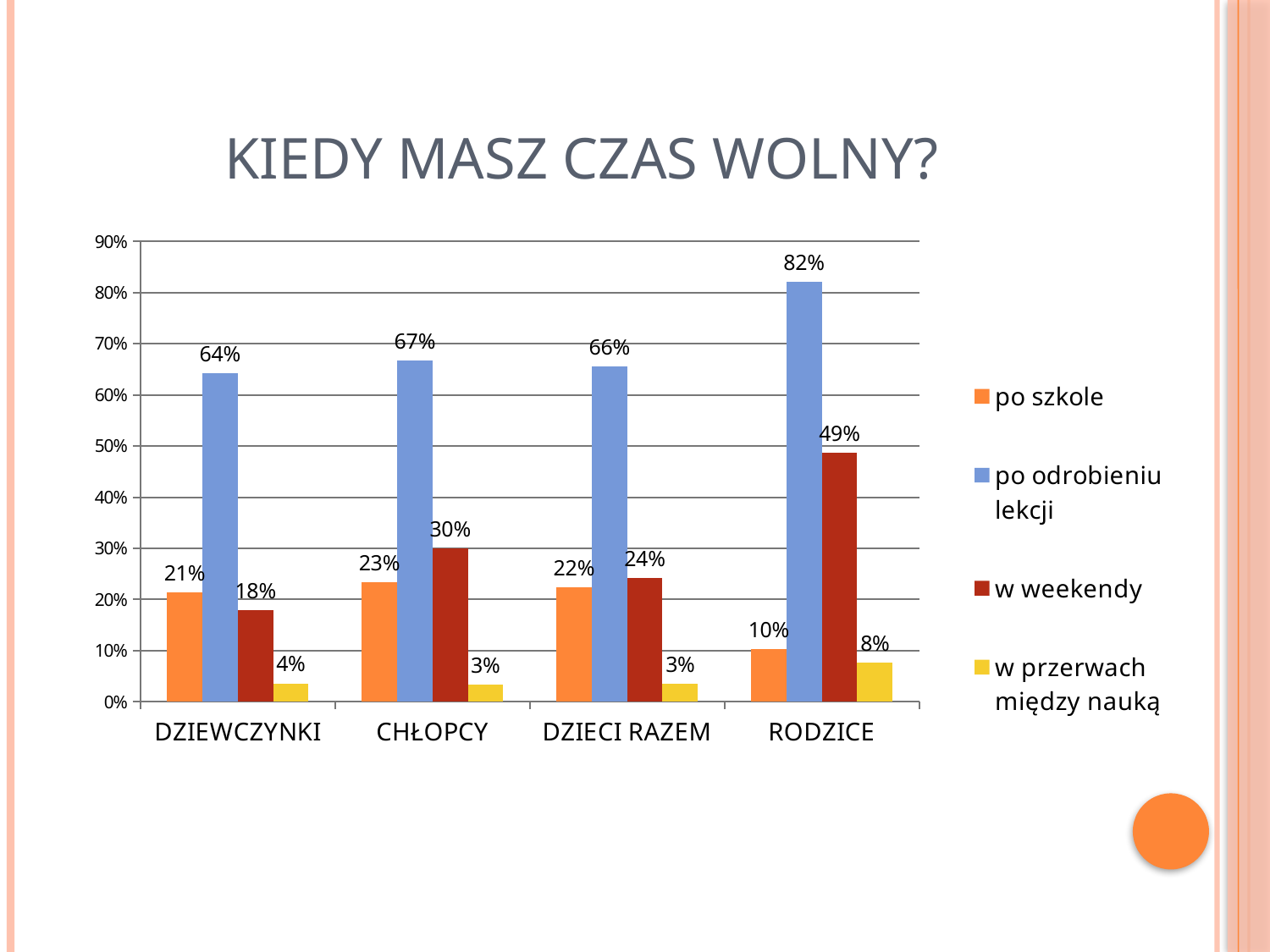
What is the title of the chart on the slide? KIEDY MASZ CZAS WOLNY? Which category has the highest value for 'po odrobieniu lekcji'? RODZICE What kind of chart is shown on the slide? Bar chart What is the difference between the 'w weekendy' values for RODZICE and DZIEWCZYNKI? 31% What is the value for 'po odrobieniu lekcji' in the RODZICE category? 82% How many categories are shown on the x axis? 4 Which is larger: 'po szkole' for CHŁOPCY or 'po szkole' for RODZICE? CHŁOPCY What is the value for 'w weekendy' in the CHŁOPCY category? 30% Which category has the lowest value for 'po szkole'? RODZICE What is the value for 'w przerwach między nauką' in the RODZICE category? 8% What is the value for 'po szkole' in the DZIEWCZYNKI category? 21% How many series does the legend list? 4